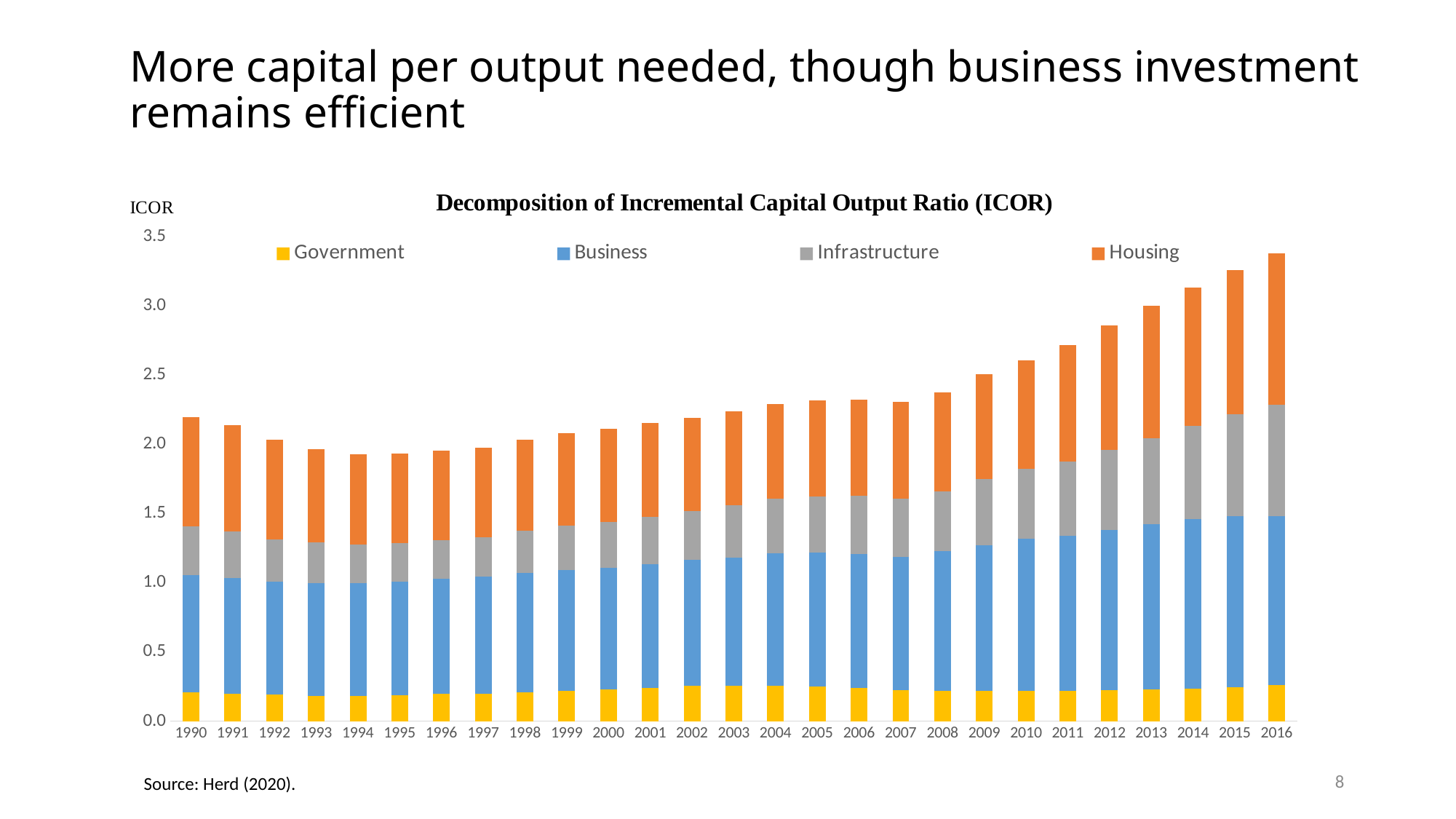
What kind of chart is shown on the slide? Stacked bar chart How many years are shown on the x axis? 27 Is the total ICOR for 1994 greater or less than 2.0? less Is the total ICOR for 1990 greater or less than 2.0? greater Which series is shown in orange in the legend? Housing Is the total ICOR for 2016 greater or less than 3.0? greater How many series does the legend list? 4 Which year has the larger total ICOR, 1990 or 2016? 2016 Which year has the highest total ICOR? 2016 Do the total ICOR values rise or fall from 2008 to 2016? rise What is the title of the chart? Decomposition of Incremental Capital Output Ratio (ICOR)